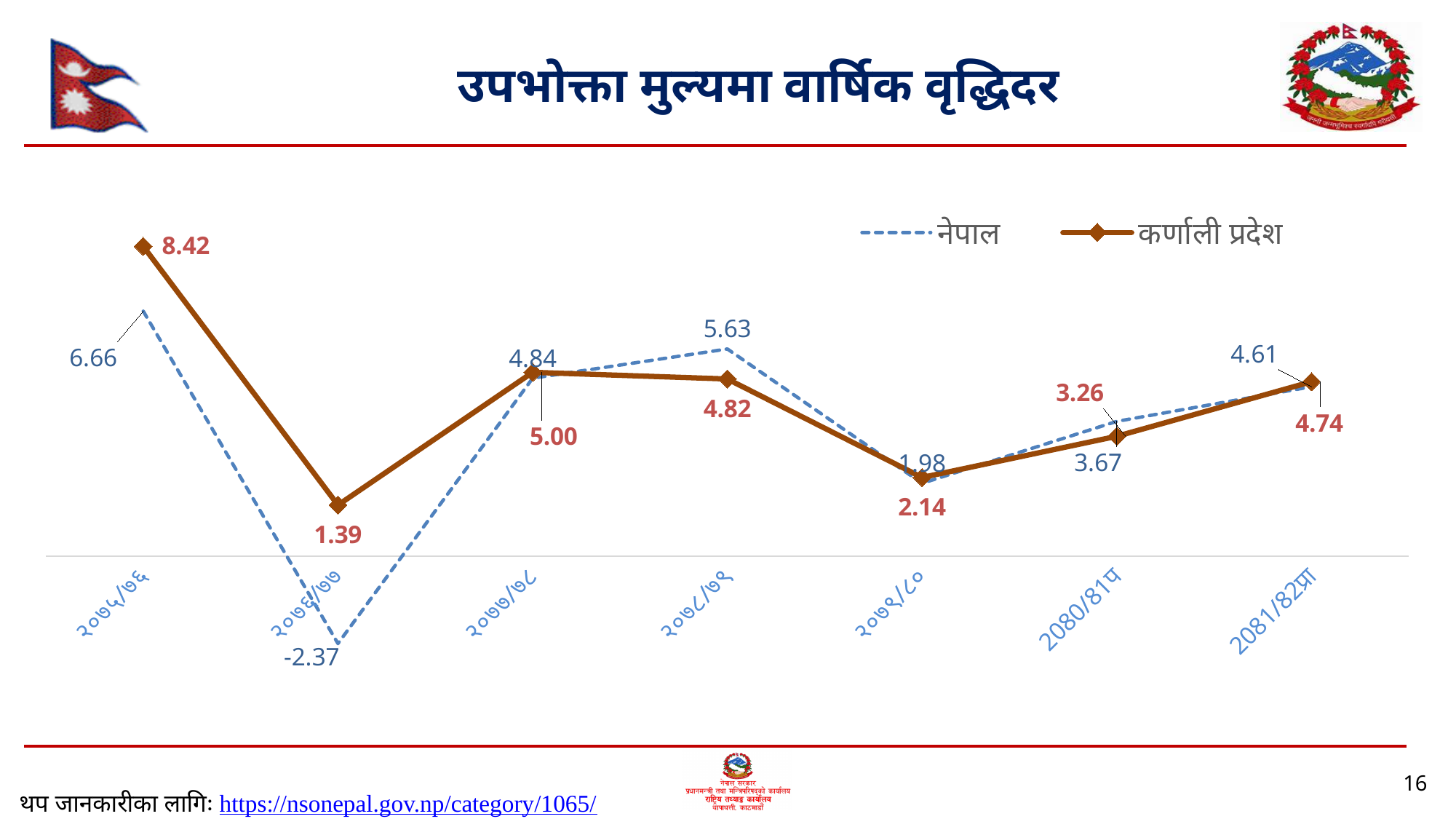
How many series does the legend list? 2 What type of chart is shown on the slide? line chart Which series has the larger value in २०७८/७९, नेपाल or कर्णाली प्रदेश? नेपाल What is the value for नेपाल in 2081/82प्रा? 4.61 In which year is the नेपाल series at its highest? २०७५/७६ How many fiscal years are plotted along the x axis? 7 What is the value for कर्णाली प्रदेश in २०७५/७६? 8.42 What is the value for नेपाल in २०७६/७७? -2.37 What is the title of the chart? उपभोक्ता मुल्यमा वार्षिक वृद्धिदर What is the value for कर्णाली प्रदेश in २०७९/८०? 2.14 What is the difference between कर्णाली प्रदेश and नेपाल in २०७५/७६? 1.76 In which year is the कर्णाली प्रदेश series at its lowest? २०७६/७७